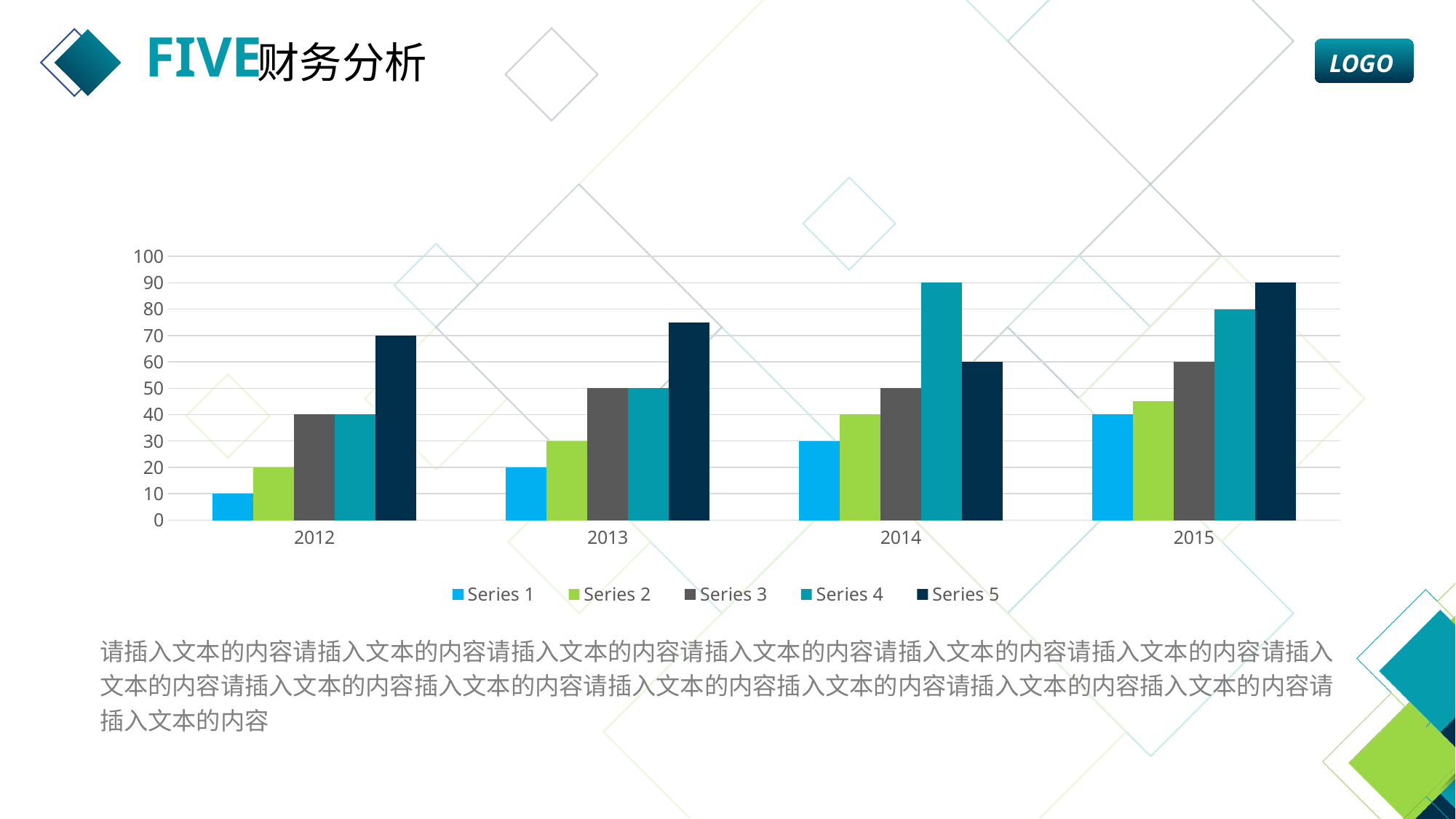
Which series has the lowest value in 2013? Series 1 Which year has the highest value for Series 1? 2015 What is the value of Series 1 in 2012? 10 What is the difference between Series 4 and Series 5 in 2014? 30 How many series does the legend list? 5 What is the value of Series 4 in 2014? 90 What kind of chart is shown on the slide? bar chart Is the value for Series 5 in 2013 greater or less than 70? greater Do the values for Series 1 rise or fall from 2012 to 2015? rise Which is larger in 2015, Series 4 or Series 5? Series 5 What is the value of Series 5 in 2012? 70 How many categories are shown on the x axis? 4